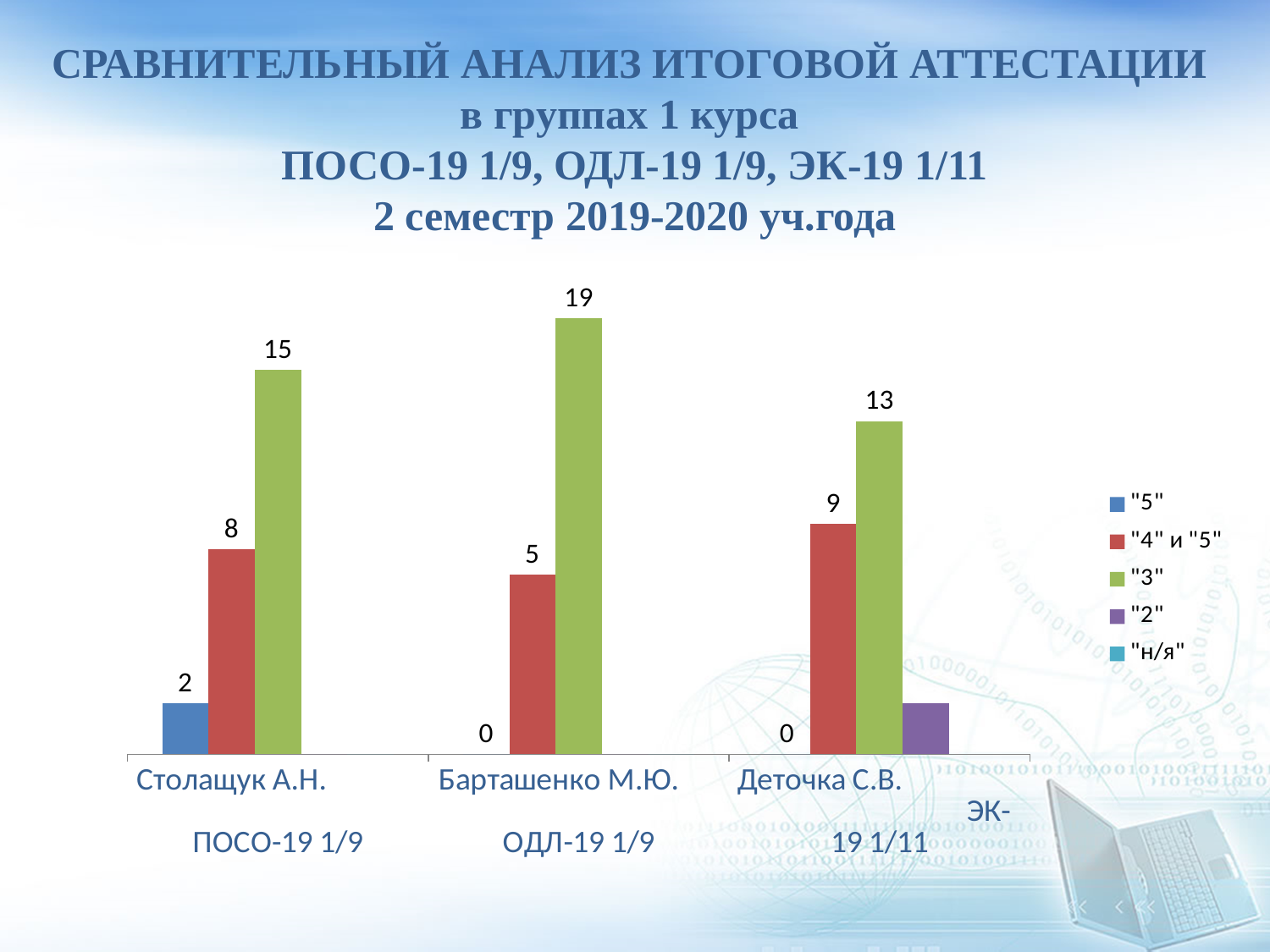
What is the value of "4" и "5" for Столащук А.Н. (ПОСО-19 1/9)? 8 Which group has the highest value for "3"? Барташенко М.Ю. (ОДЛ-19 1/9) Which group has the lowest value for "4" и "5"? Барташенко М.Ю. (ОДЛ-19 1/9) What is the value of "5" for Деточка С.В. (ЭК-19 1/11)? 0 What is the value of "3" for Барташенко М.Ю. (ОДЛ-19 1/9)? 19 What kind of chart is shown on the slide? bar chart Which group is the only one with a non-zero value for "5"? Столащук А.Н. (ПОСО-19 1/9) How many groups (categories) are shown on the x axis? 3 What is the difference between the "3" values for Барташенко М.Ю. and Столащук А.Н.? 4 Which is larger: the "4" и "5" value for Деточка С.В. or for Столащук А.Н.? Деточка С.В. What is the value of "3" for Деточка С.В. (ЭК-19 1/11)? 13 How many series does the legend list? 5